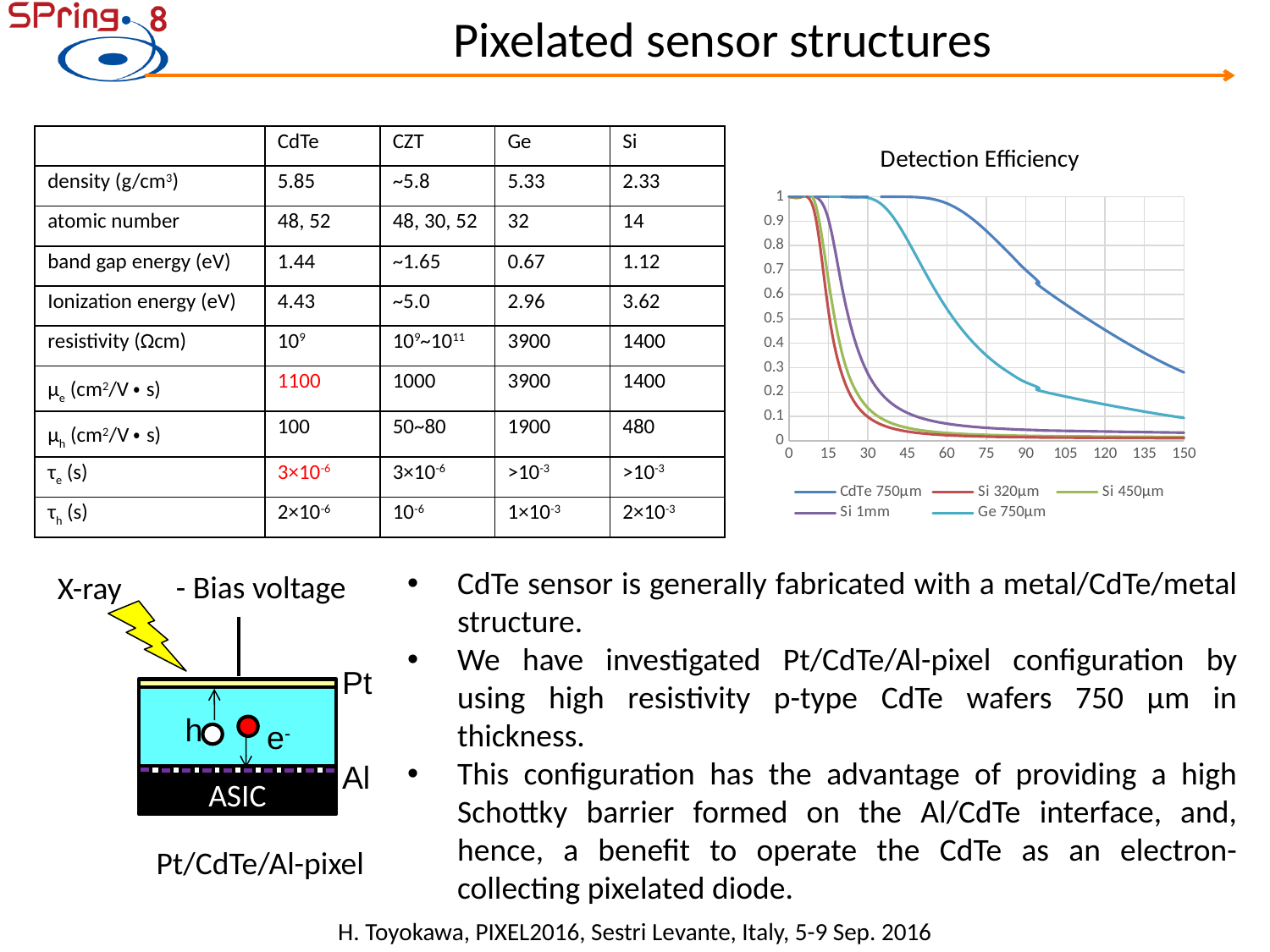
In the Detection Efficiency chart, is the value for Si 320μm at x = 60 greater or less than 0.1? less What is the title of the chart on the slide? Detection Efficiency In the Detection Efficiency chart, which series has the highest value at x = 150? CdTe 750μm In the Detection Efficiency chart, is the value for Ge 750μm at x = 75 greater or less than 0.5? less In the Detection Efficiency chart, at x = 90, which is larger: CdTe 750μm or Ge 750μm? CdTe 750μm In the Detection Efficiency chart, is the value for CdTe 750μm at x = 60 greater or less than 0.9? greater Which series are listed in the legend of the Detection Efficiency chart? CdTe 750μm, Si 320μm, Si 450μm, Si 1mm, Ge 750μm In the Detection Efficiency chart, do the values rise or fall as the x axis increases? fall How many series does the legend of the Detection Efficiency chart list? 5 In the Detection Efficiency chart, which series has the lowest value at x = 30? Si 320μm What kind of chart is the Detection Efficiency chart? line chart